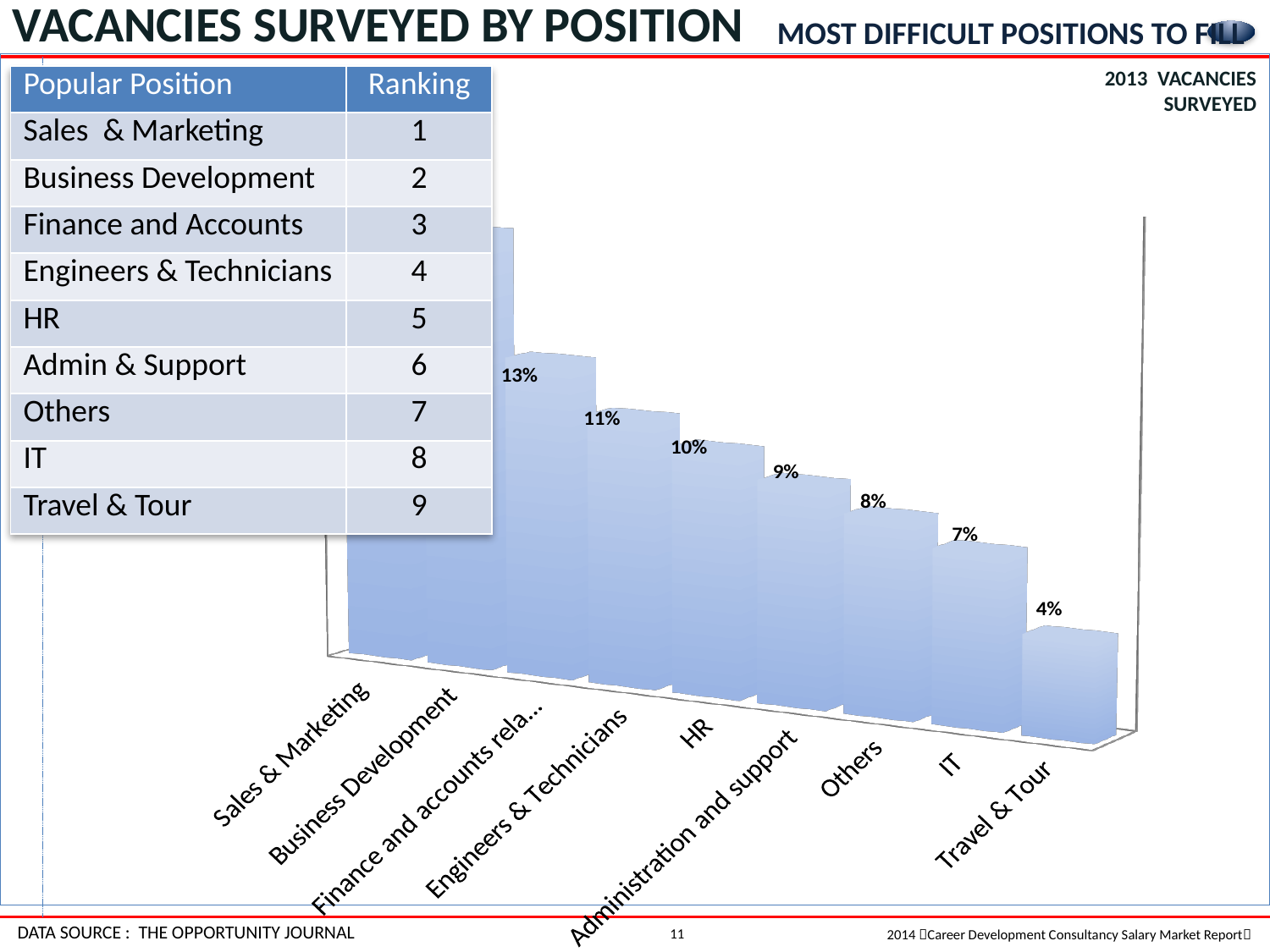
Do the bar values rise or fall moving from left to right along the x axis? fall What kind of chart is shown on the slide? bar chart How many positions (categories) are plotted in the bar chart? 9 Which position has the tallest bar in the chart? Sales & Marketing What is the difference between the values for Others and Travel & Tour? 4% What is the value shown for HR? 10% Which is larger, the value for HR or the value for IT? HR What is the value shown for IT? 7% What is the value shown for Travel & Tour? 4% What is the value shown for Administration and support? 9% What is the value shown for Others? 8% Which position has the shortest bar in the chart? Travel & Tour